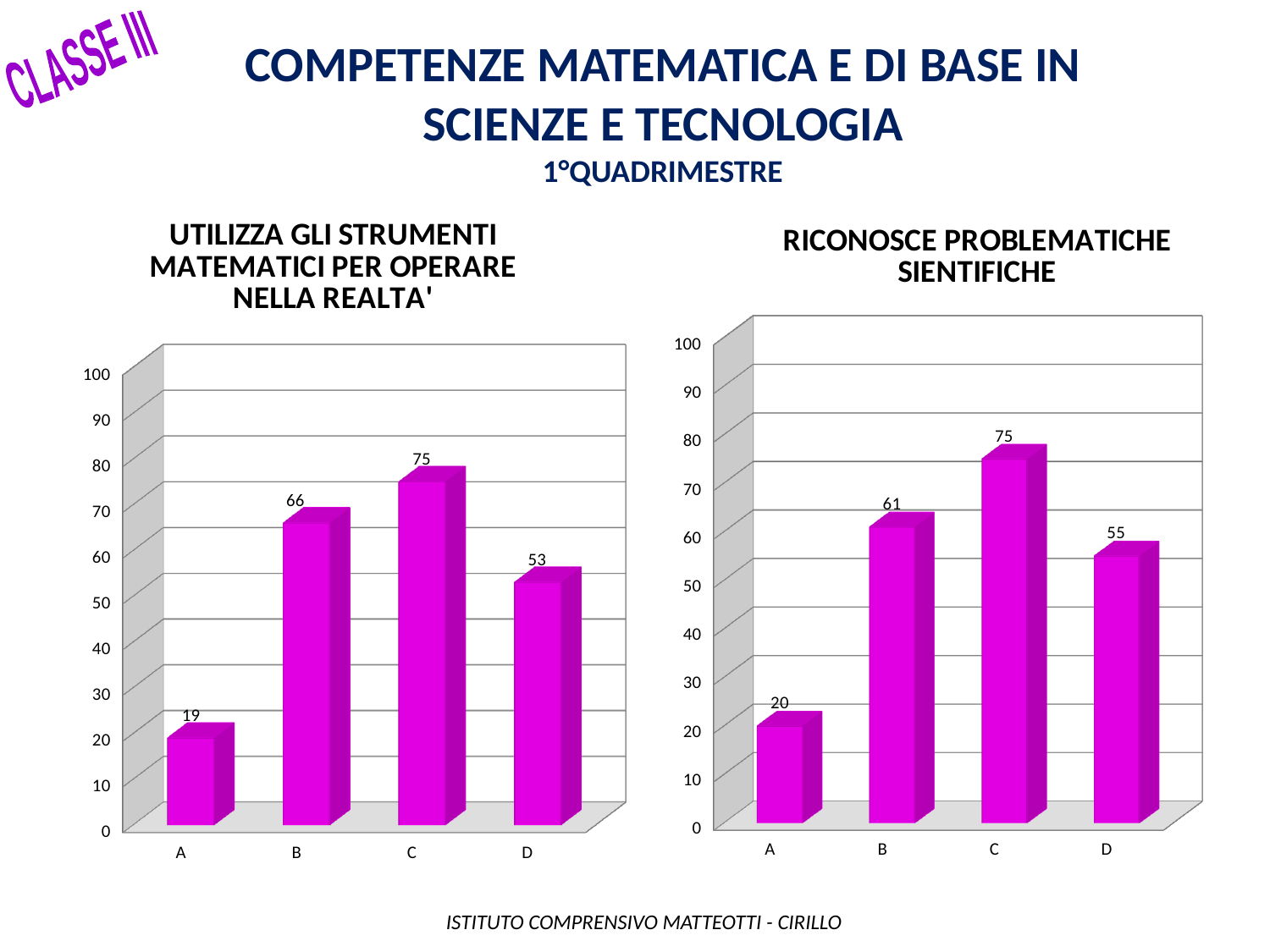
In the left chart (UTILIZZA GLI STRUMENTI MATEMATICI PER OPERARE NELLA REALTA'), is the value for D greater or less than 50? greater In the right chart (RICONOSCE PROBLEMATICHE SIENTIFICHE), which is larger, the value for B or the value for D? B What kind of chart is the left chart (UTILIZZA GLI STRUMENTI MATEMATICI PER OPERARE NELLA REALTA')? Bar chart What colour are the bars in the right chart (RICONOSCE PROBLEMATICHE SIENTIFICHE)? Magenta In the left chart (UTILIZZA GLI STRUMENTI MATEMATICI PER OPERARE NELLA REALTA'), what is the value for category A? 19 In the left chart (UTILIZZA GLI STRUMENTI MATEMATICI PER OPERARE NELLA REALTA'), which category has the highest value? C In the left chart (UTILIZZA GLI STRUMENTI MATEMATICI PER OPERARE NELLA REALTA'), what is the difference between the values for C and A? 56 In the right chart (RICONOSCE PROBLEMATICHE SIENTIFICHE), what is the difference between the values for B and D? 6 In the right chart (RICONOSCE PROBLEMATICHE SIENTIFICHE), what is the value for category D? 55 In the left chart (UTILIZZA GLI STRUMENTI MATEMATICI PER OPERARE NELLA REALTA'), what is the value for category B? 66 In the right chart (RICONOSCE PROBLEMATICHE SIENTIFICHE), which category has the lowest value? A How many categories are shown in the right chart (RICONOSCE PROBLEMATICHE SIENTIFICHE)? 4